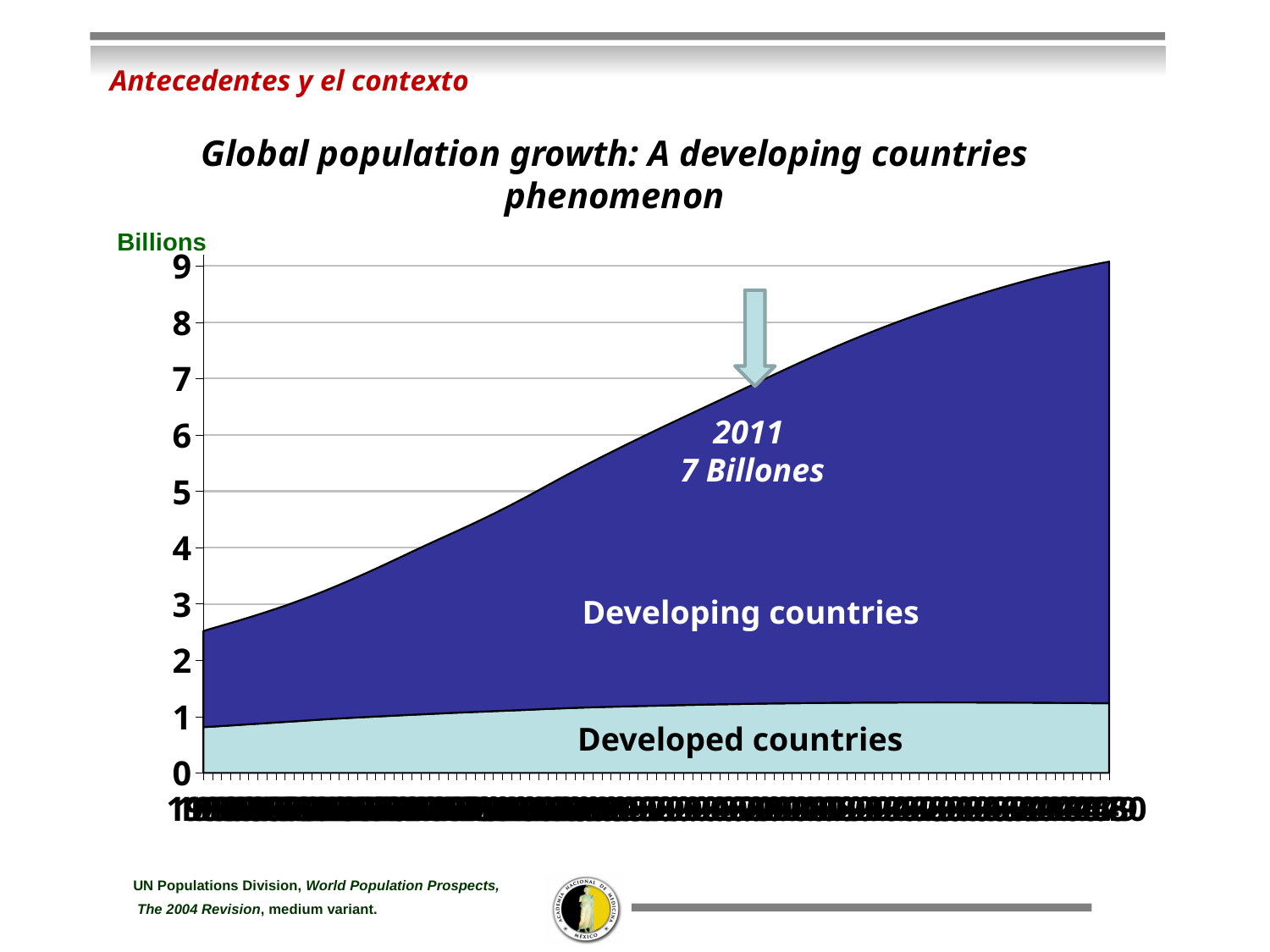
Is the value for Developed countries at the right end of the chart greater or less than 2 billion? less Which series occupies the larger area in the chart, Developing countries or Developed countries? Developing countries Does the total population in the chart rise or fall from left to right? Rise What unit is shown on the vertical axis of the chart? Billions Which series is plotted at the bottom of the stacked area chart? Developed countries What is the highest value shown on the vertical axis of the chart? 9 Is the total population at the left end of the chart greater or less than 3 billion? less What kind of chart is shown on the slide? Area chart Is the total population at the right end of the chart greater or less than 8 billion? greater According to the annotation on the chart, what population total is reached in 2011? 7 Billones How many series (country groups) are plotted in the chart? 2